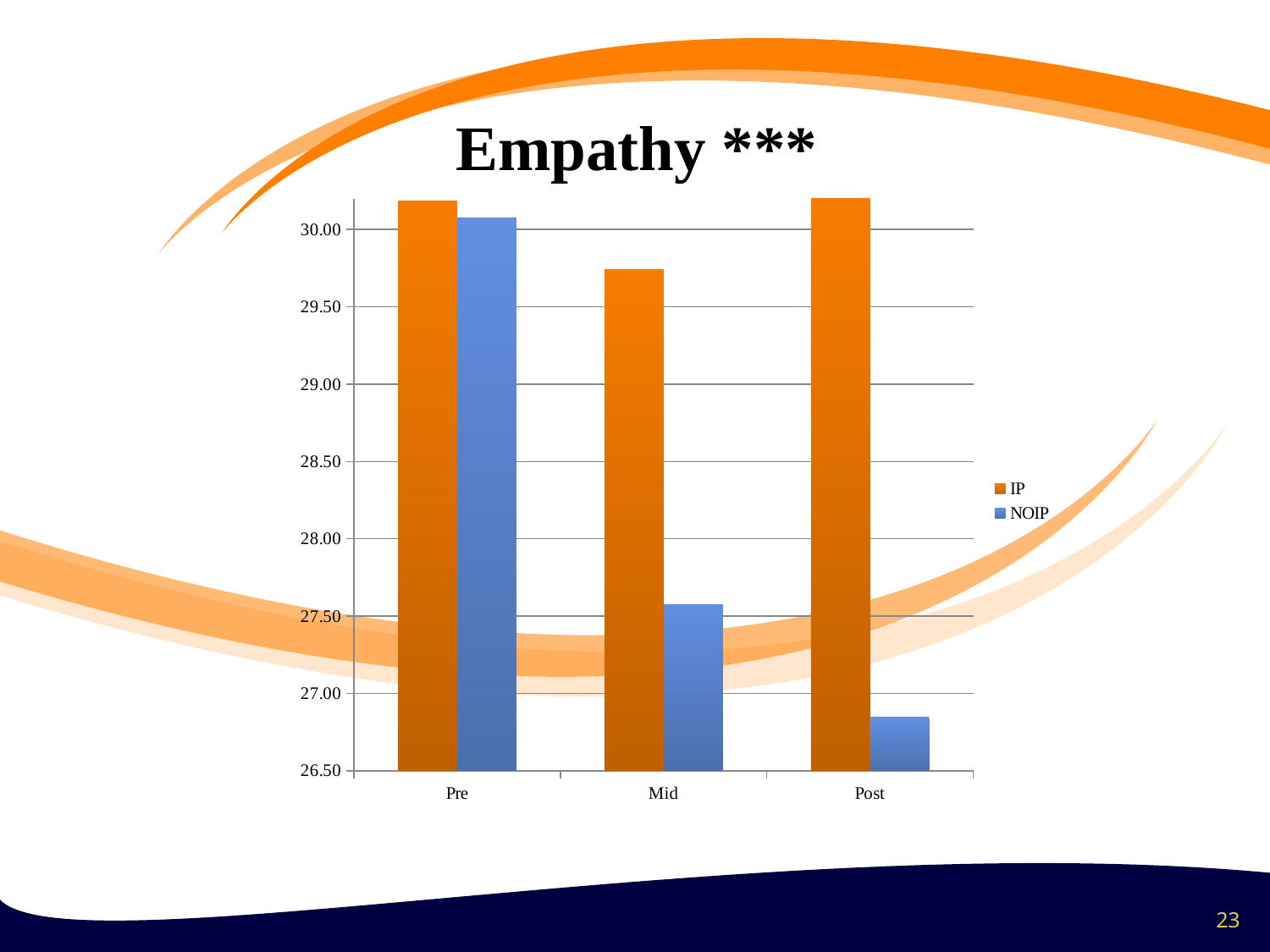
Do the NOIP values rise or fall from Pre to Post? fall At which category is the NOIP value lowest? Post Is the value for IP at Mid greater or less than 29.50? greater What kind of chart is shown on the slide? bar chart Is the value for NOIP at Mid greater or less than 28.00? less Is the value for NOIP at Post greater or less than 27.00? less How many categories are shown on the x axis? 3 Which series is shown in orange? IP What is the title of the chart? Empathy *** How many series does the legend list? 2 At which category is the IP value lowest? Mid